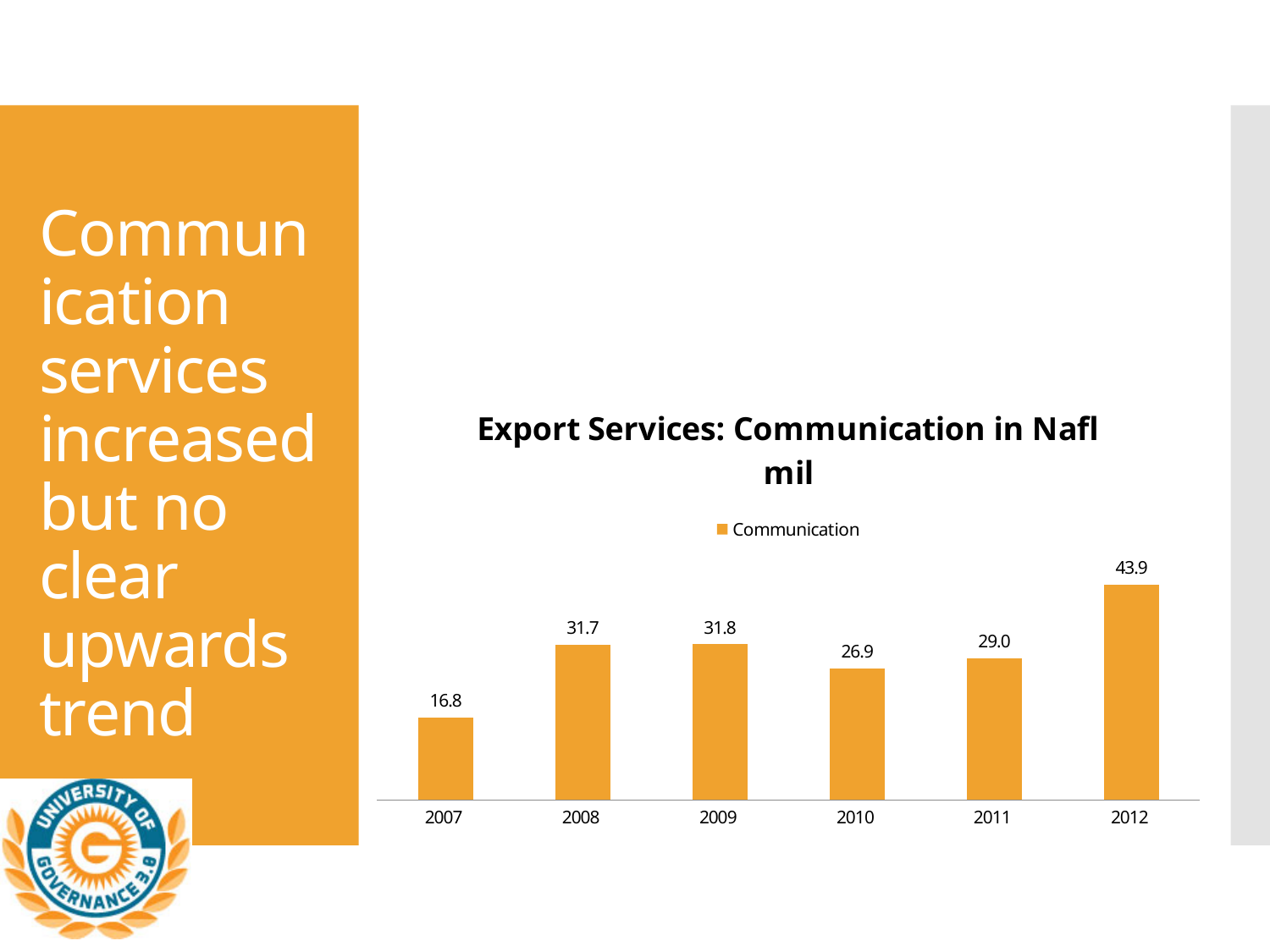
Which year has the lowest value? 2007 Which is larger, the value for 2008 or the value for 2011? 2008 How many years are shown on the x axis? 6 What is the value for 2007? 16.8 What is the difference between the values for 2012 and 2007? 27.1 How many series does the legend list? 1 What is the title of the chart? Export Services: Communication in Nafl mil What kind of chart is shown? bar chart What is the value for 2012? 43.9 What is the value for 2010? 26.9 What is the difference between the values for 2011 and 2010? 2.1 Which year has the highest value? 2012